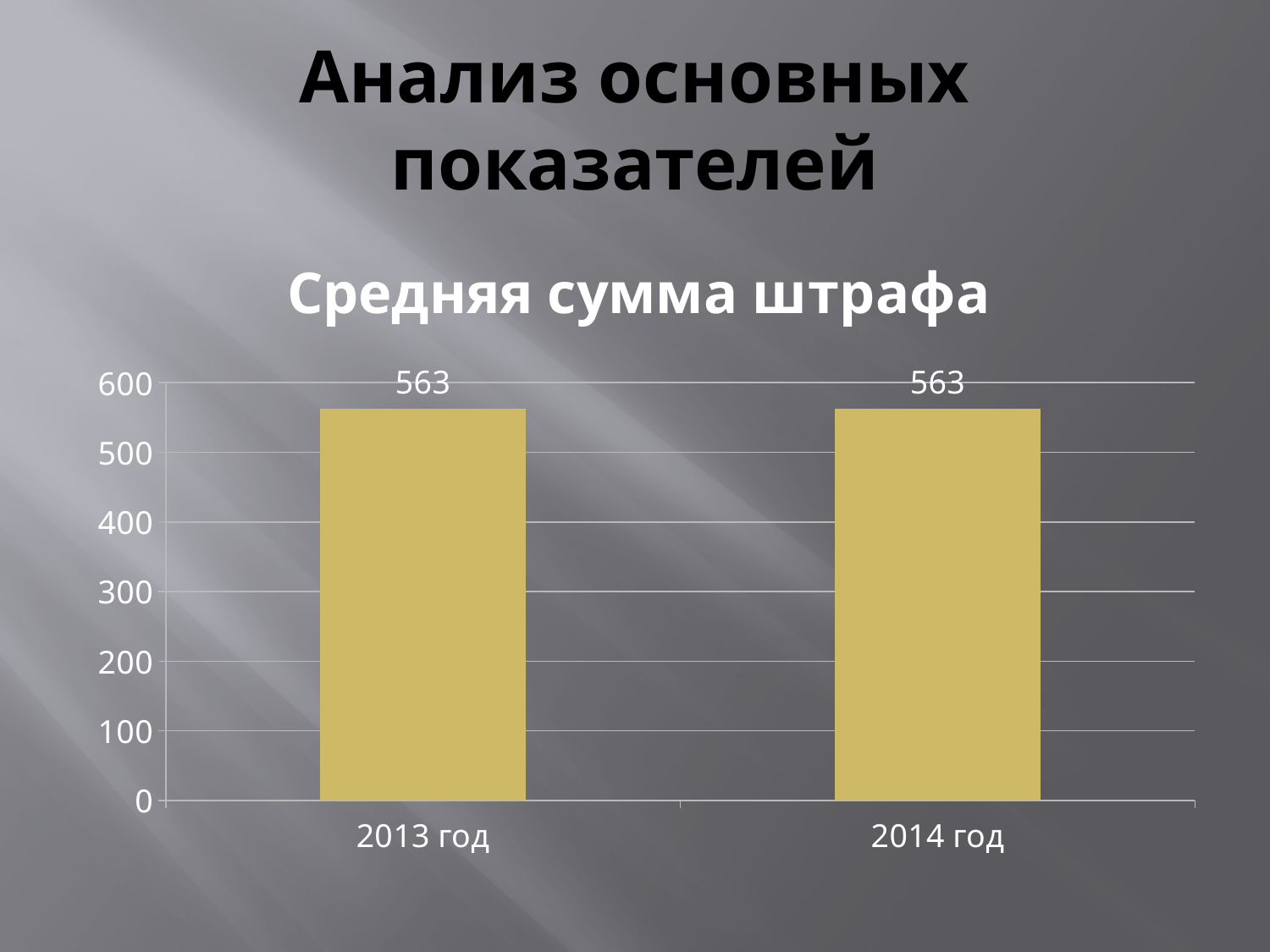
Is the value for 2013 год greater or less than 500? greater Is the value for 2014 год greater or less than 600? less What is the difference between the values for 2013 год and 2014 год? 0 Do the values rise, fall or stay the same from 2013 год to 2014 год? stay the same What is the title of the chart? Средняя сумма штрафа What is the value for 2013 год? 563 What kind of chart is shown on the slide? bar chart How many categories are shown on the x axis? 2 What colour are the bars in the chart? yellow What is the highest value shown on the vertical axis? 600 What is the value for 2014 год? 563